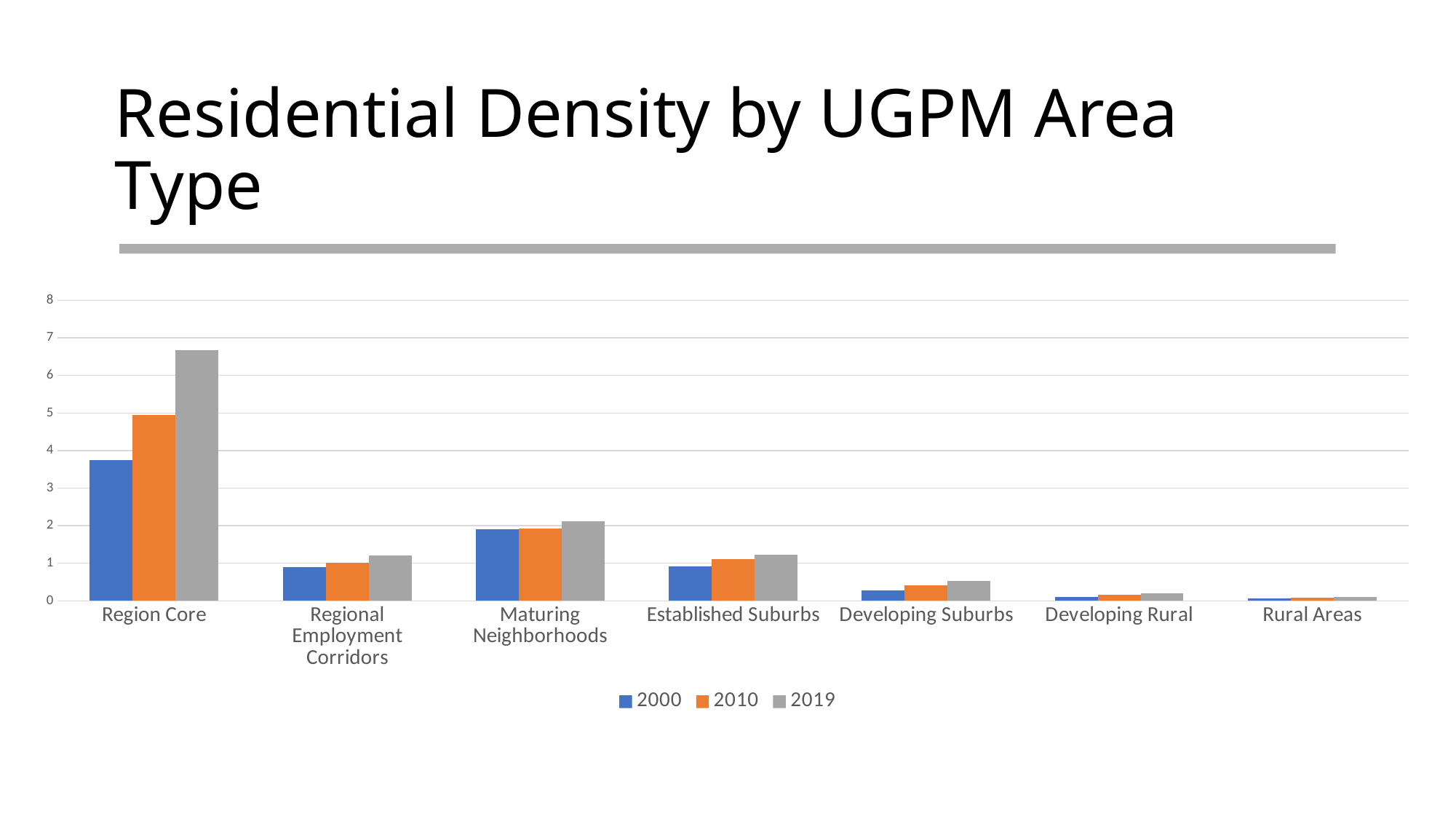
Which area type has the lowest 2019 residential density? Rural Areas Is the 2019 value for Established Suburbs greater or less than 1? greater What is the title of the slide? Residential Density by UGPM Area Type Which is larger, the 2010 value for Region Core or the 2010 value for Maturing Neighborhoods? Region Core Is the 2000 value for Region Core greater or less than 4? less What kind of chart is shown on the slide? Bar chart Which area type has the highest 2019 residential density? Region Core Which years are listed in the legend? 2000, 2010, 2019 Is the 2019 value for Region Core greater or less than 6? greater Do the values for Region Core rise or fall from 2000 to 2010 to 2019? Rise How many series does the legend list? 3 How many area type categories are shown on the x axis? 7